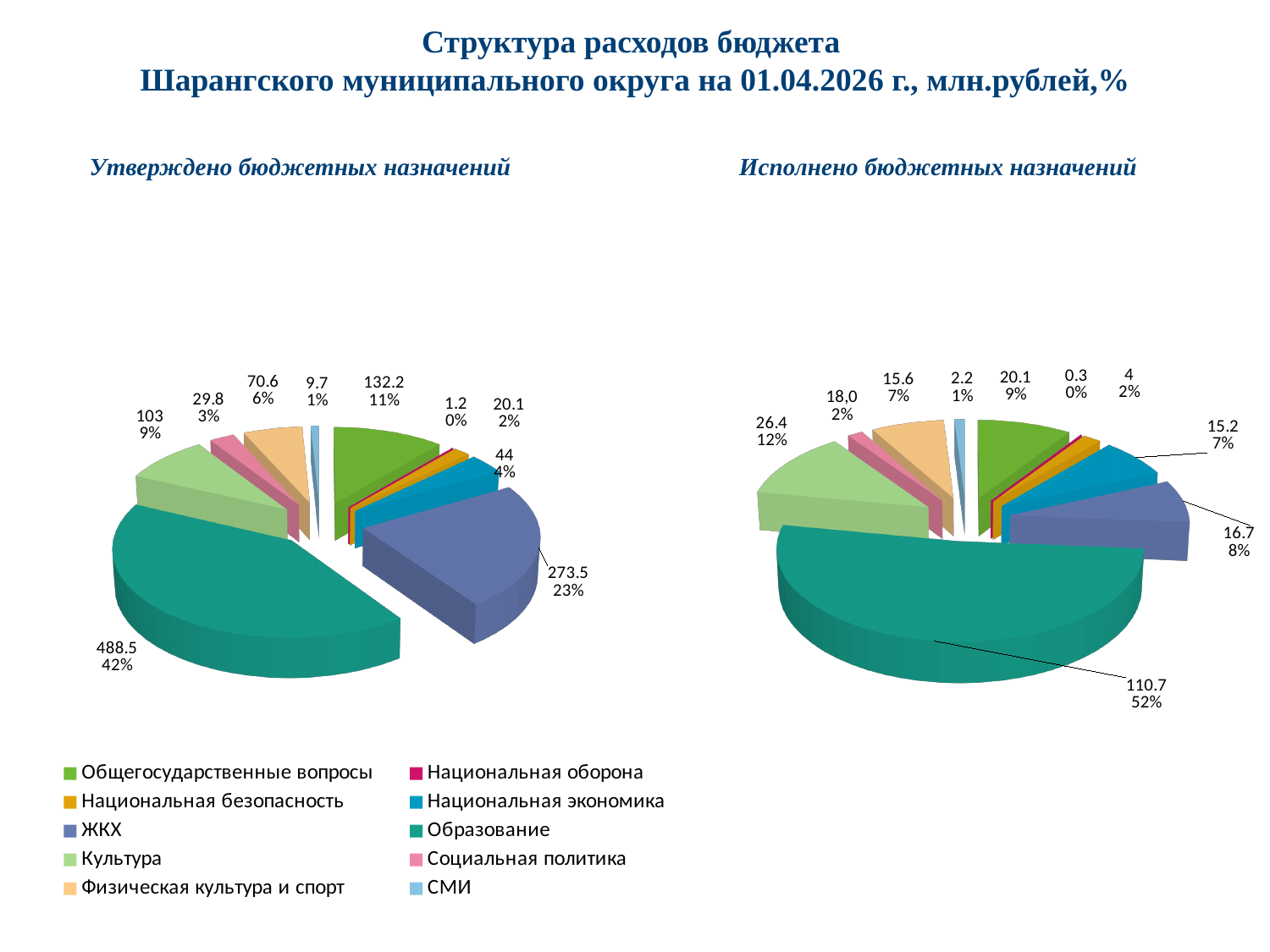
In the left pie chart (Утверждено бюджетных назначений), what share of the pie does Общегосударственные вопросы take? 11% In the left pie chart (Утверждено бюджетных назначений), what value is shown for ЖКХ? 273.5 In the right pie chart (Исполнено бюджетных назначений), what value is shown for Образование? 110.7 In the left pie chart (Утверждено бюджетных назначений), what value is shown for Образование? 488.5 What type of chart is used on this slide? Pie chart In the right pie chart (Исполнено бюджетных назначений), which is larger, the value for Национальная экономика or the value for ЖКХ? ЖКХ In the right pie chart (Исполнено бюджетных назначений), what share of the pie does Образование take? 52% In the right pie chart (Исполнено бюджетных назначений), what value is shown for Культура? 26.4 How many categories does the legend list? 10 In the left pie chart (Утверждено бюджетных назначений), what is the difference between the values for Образование and ЖКХ? 215 In the left pie chart (Утверждено бюджетных назначений), which category has the smallest slice? Национальная оборона In the left pie chart (Утверждено бюджетных назначений), which category has the largest slice? Образование